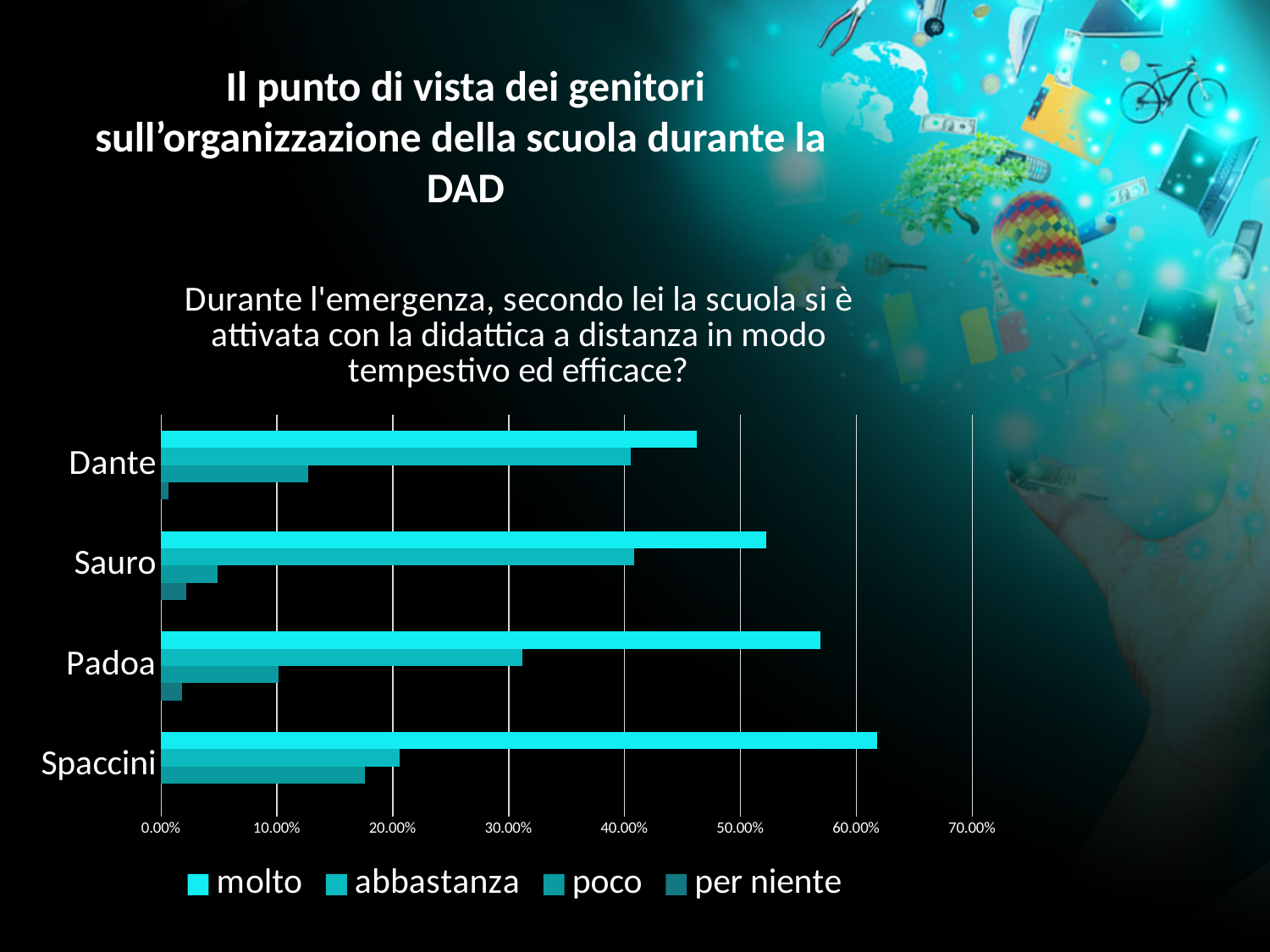
How many series does the legend list? 4 Which series is listed first in the legend? molto What kind of chart is shown on the slide? bar chart What is the question shown as the chart title? Durante l'emergenza, secondo lei la scuola si è attivata con la didattica a distanza in modo tempestivo ed efficace? Is the value for "abbastanza" at Padoa greater or less than 40.00%? less Which school has the lowest value for "molto"? Dante Which school has the highest value for "molto"? Spaccini How many schools (categories) are shown on the chart? 4 Which is larger for Padoa: "molto" or "abbastanza"? molto Which school has the highest value for "poco"? Spaccini Is the value for "poco" at Dante greater or less than 10.00%? greater Is the value for "molto" at Spaccini greater or less than 60.00%? greater